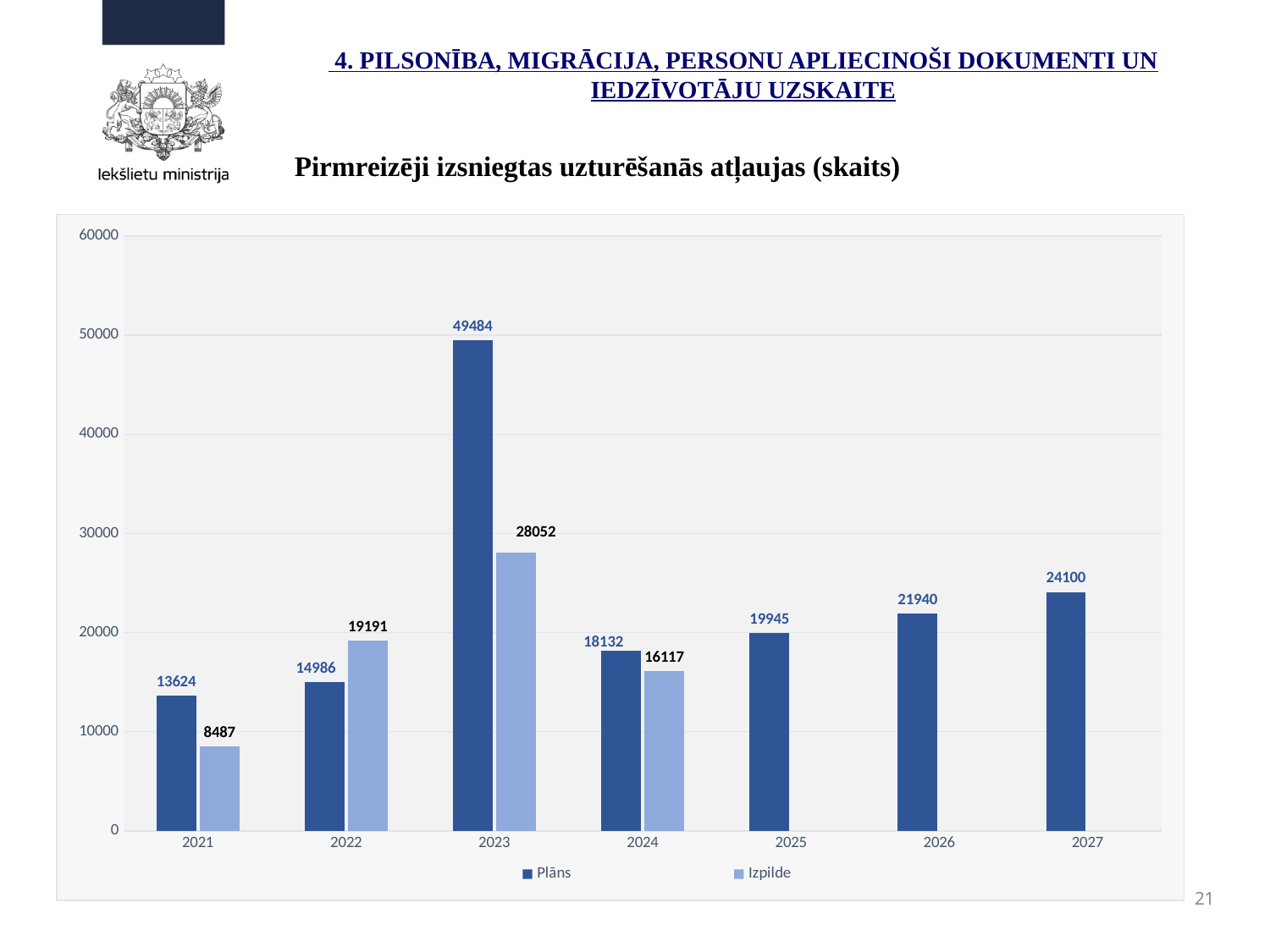
What is the Plāns value for 2027? 24100 What kind of chart is shown on the slide? Bar chart Which year has the highest Plāns value? 2023 What is the difference between the Plāns and Izpilde values for 2023? 21432 What is the Plāns value for 2023? 49484 Which year has the lowest Izpilde value? 2021 How many series does the legend list? 2 What is the Izpilde value for 2021? 8487 Which is larger for 2022, the Plāns value or the Izpilde value? Izpilde How many years are shown on the x axis? 7 Do the Plāns values rise or fall from 2024 to 2027? Rise Is the Plāns value for 2026 greater or less than 20000? greater